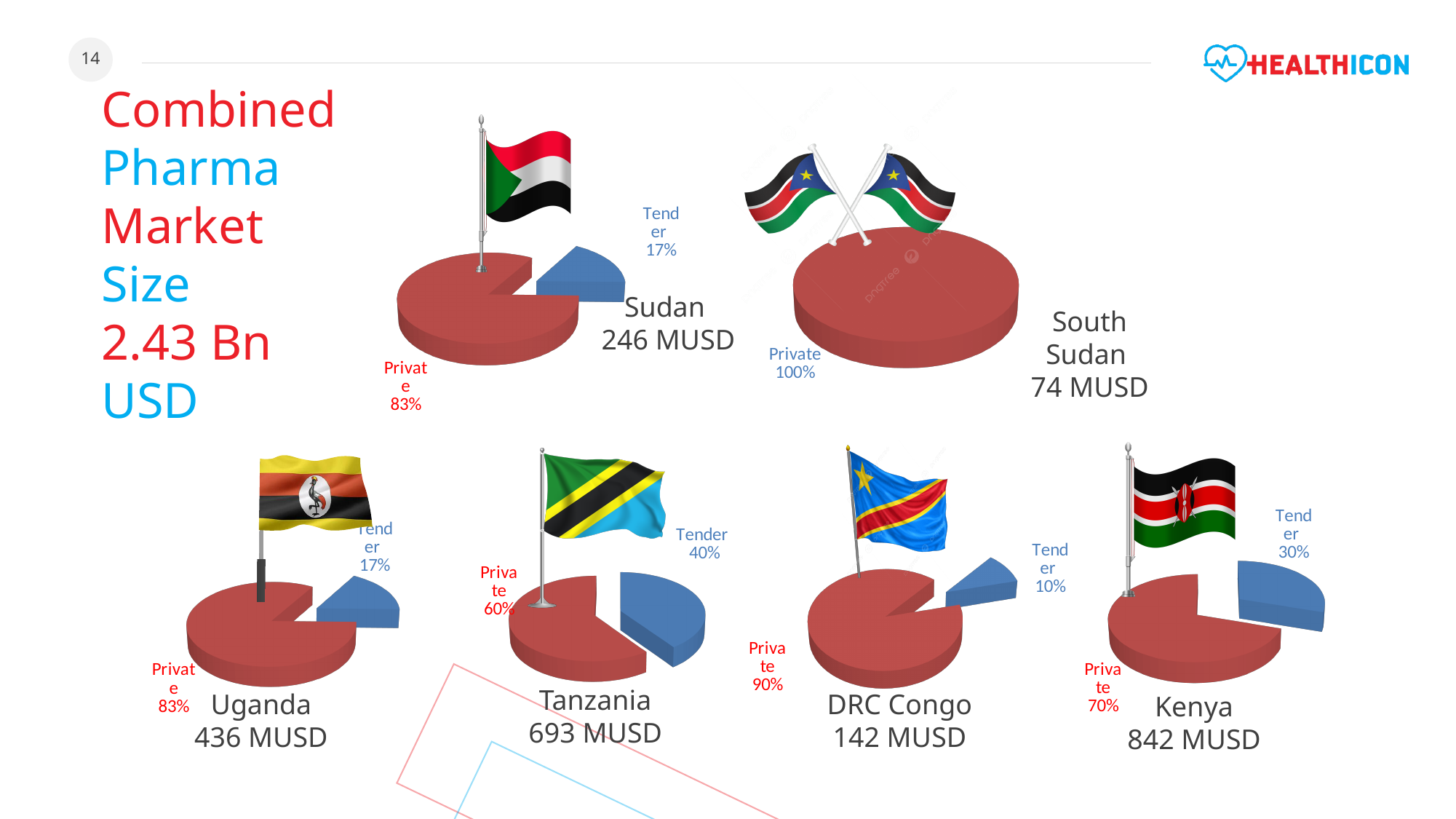
In the Kenya pie chart, what share is Tender? 30% In the Sudan pie chart, what colour is the Tender slice? Blue How many pie charts are shown on the slide? 6 In the Kenya pie chart, how many slices are there? 2 In the Sudan pie chart, what share is Tender? 17% What type of chart is used for DRC Congo? Pie chart In the Uganda pie chart, which slice is larger, Private or Tender? Private In the Sudan pie chart, what share is Private? 83% In the Tanzania pie chart, what is the difference between the Private and Tender shares? 20%